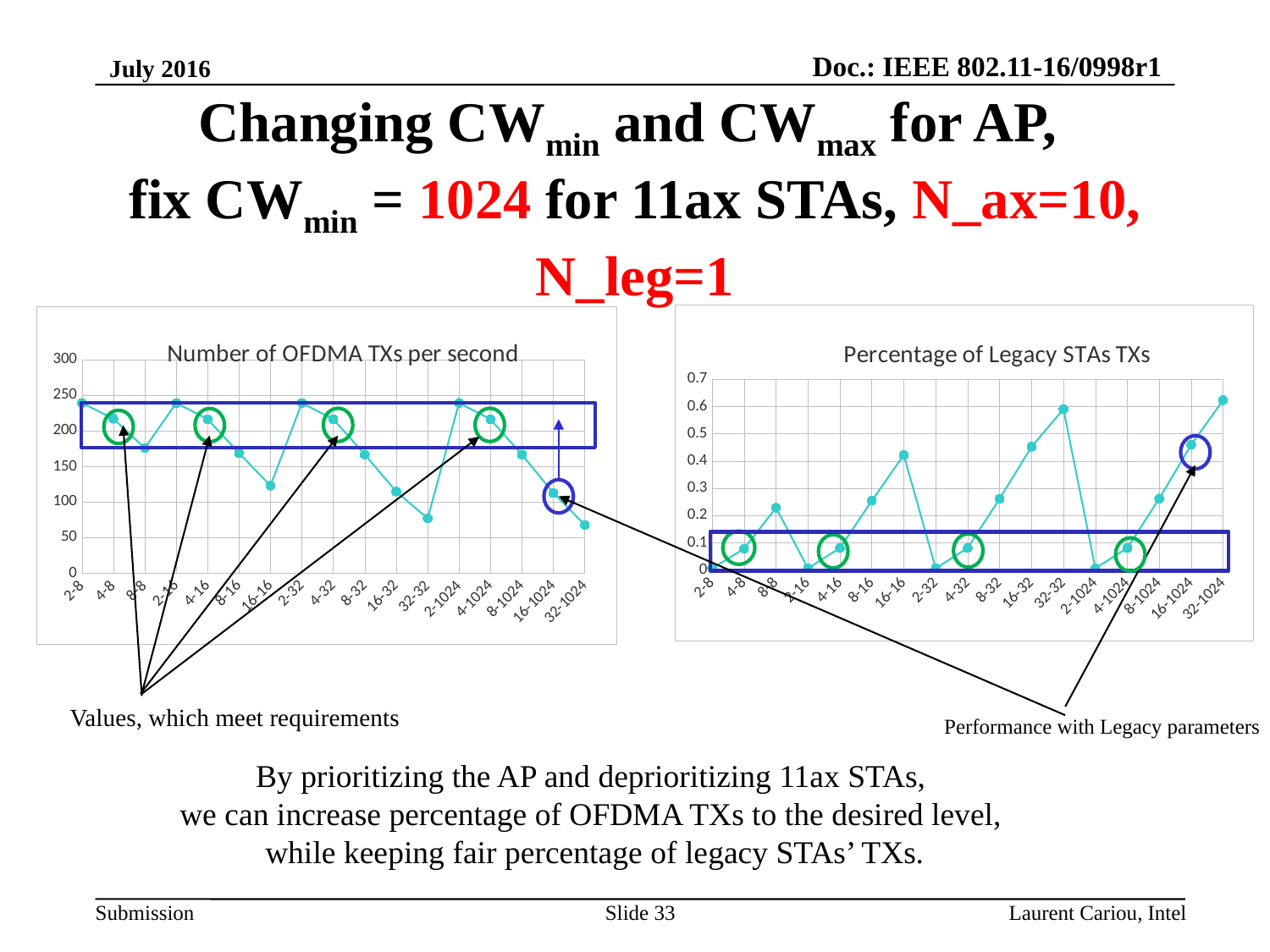
In the 'Percentage of Legacy STAs TXs' chart, is the value for 8-8 greater or less than 0.3? less In the 'Number of OFDMA TXs per second' chart, is the value for 32-32 greater or less than 100? less In the 'Number of OFDMA TXs per second' chart, is the value for 2-8 greater or less than 200? greater What type of chart is the 'Number of OFDMA TXs per second' chart? line chart What is the title of the chart on the right side of the slide? Percentage of Legacy STAs TXs What is the highest value shown on the y axis of the 'Number of OFDMA TXs per second' chart? 300 In the 'Number of OFDMA TXs per second' chart, which is larger, the value for 16-16 or the value for 32-32? 16-16 In the 'Percentage of Legacy STAs TXs' chart, which is larger, the value for 16-16 or the value for 8-8? 16-16 How many categories are shown on the x axis of the 'Percentage of Legacy STAs TXs' chart? 17